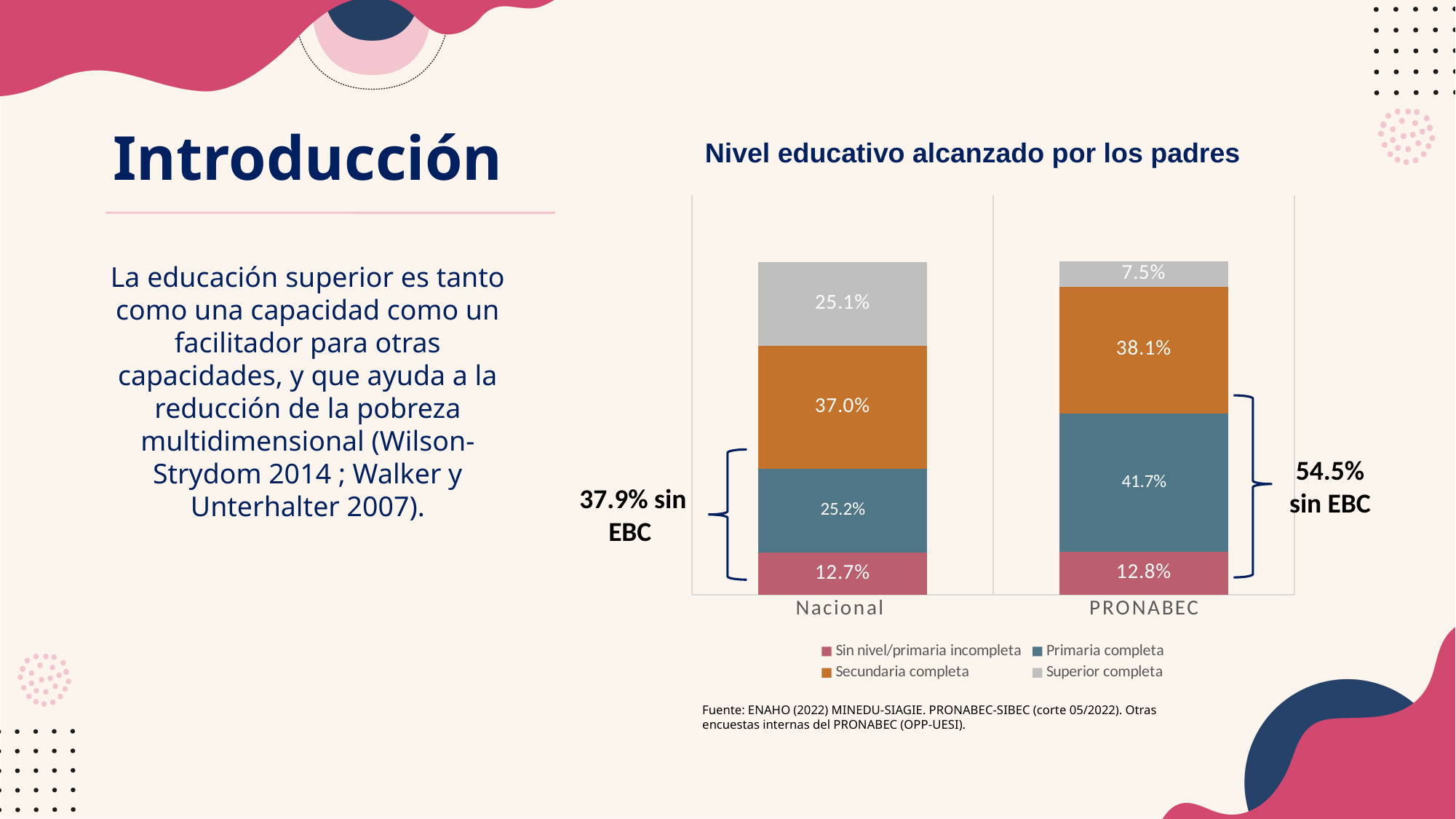
Which segment is the largest in the PRONABEC bar? Primaria completa How many series does the legend list? 4 What is the value for Secundaria completa in the Nacional bar? 37.0% How many categories are shown on the x axis? 2 Which segment is the smallest in the PRONABEC bar? Superior completa What is the value for Sin nivel/primaria incompleta in the Nacional bar? 12.7% What is the value for Superior completa in the PRONABEC bar? 7.5% What is the title of the chart? Nivel educativo alcanzado por los padres What is the difference between the Superior completa values for Nacional and PRONABEC? 17.6% What is the value for Primaria completa in the PRONABEC bar? 41.7% Which bar has the larger Primaria completa value, Nacional or PRONABEC? PRONABEC What kind of chart is shown on the slide? Stacked bar chart